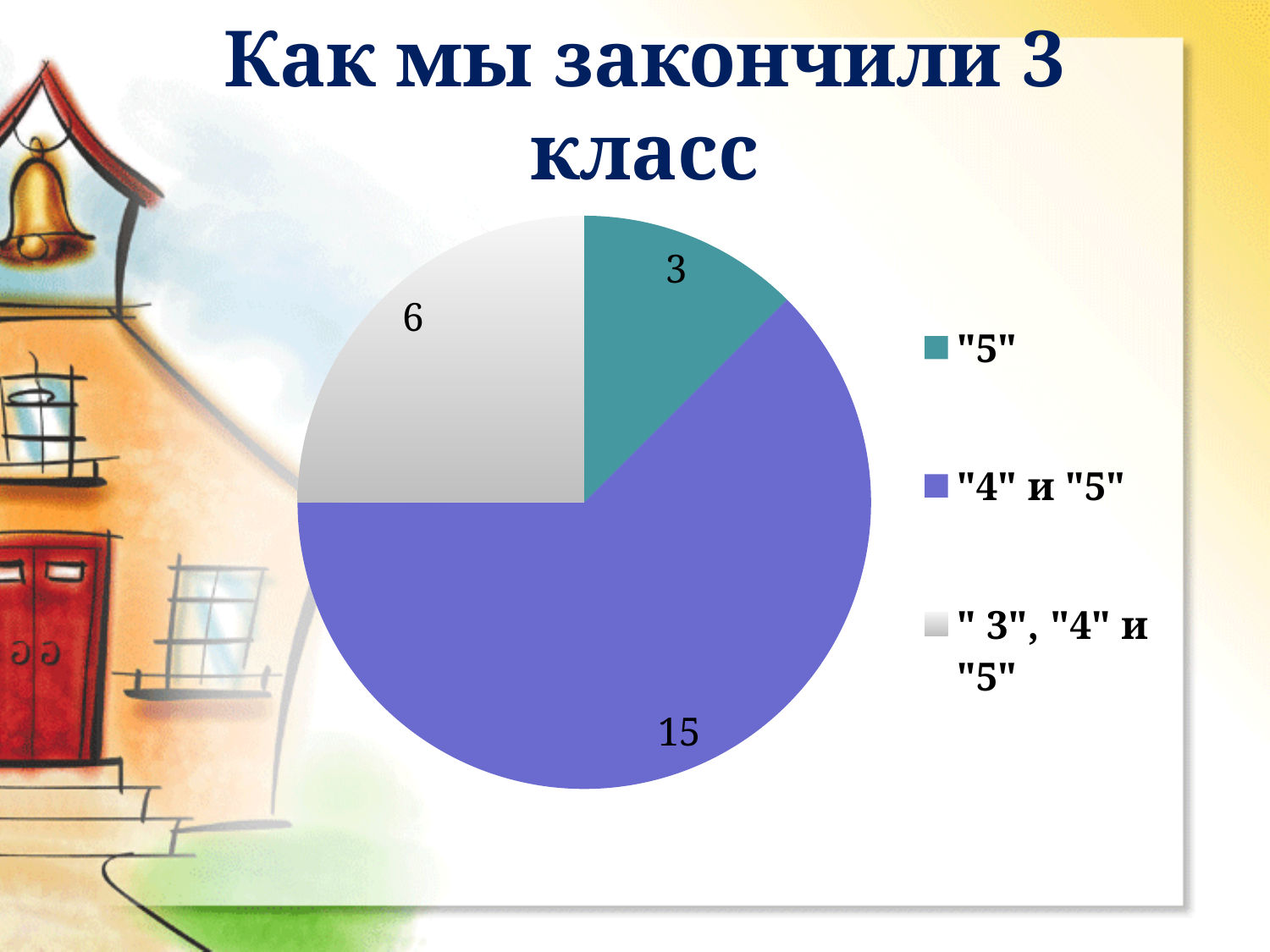
Which category has the smallest slice? "5" Which is larger: the value for "5" or the value for " 3", "4" и "5"? " 3", "4" и "5" What is the value for the "5" slice? 3 What type of chart is shown on the slide? pie chart What is the total of all slices in the pie chart? 24 Which category has the largest slice? "4" и "5" What is the value for the " 3", "4" и "5" slice? 6 How many slices does the pie chart have? 3 What is the value for the "4" и "5" slice? 15 What is the title of the chart slide? Как мы закончили 3 класс What share of the pie does the " 3", "4" и "5" slice represent? 25% What is the difference between the "4" и "5" value and the " 3", "4" и "5" value? 9